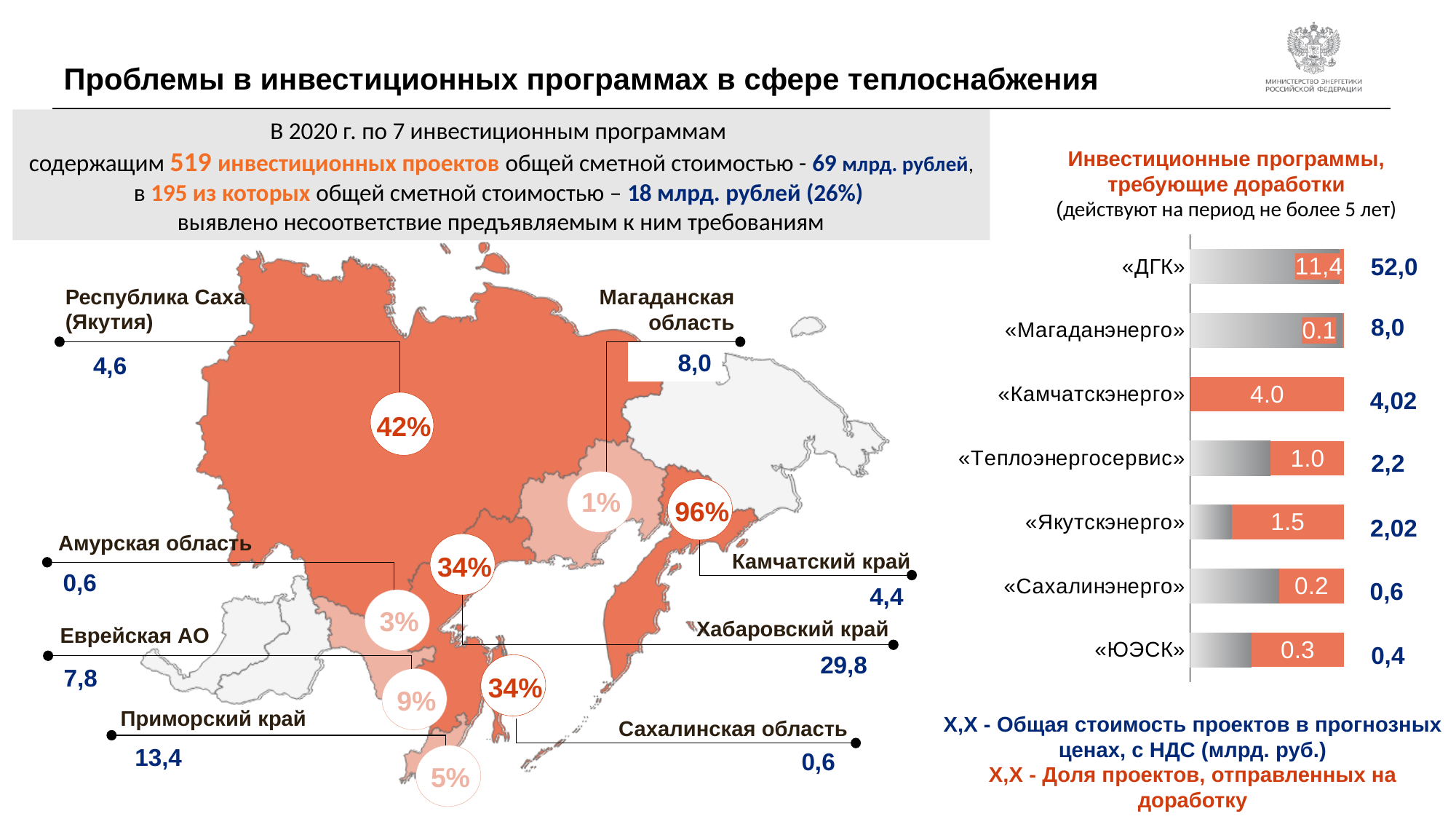
In the bar chart, which company has the highest total value shown to the right of the bars? «ДГК» In the bar chart, what total value is shown to the right of the bar for «ДГК»? 52,0 In the bar chart, what value is printed inside the bar for «ДГК»? 11,4 In the bar chart, which has the larger total value to the right of the bar: «Магаданэнерго» or «Сахалинэнерго»? «Магаданэнерго» How many companies are listed in the bar chart «Инвестиционные программы, требующие доработки»? 7 In the bar chart, what is the difference between the total values shown for «ДГК» (52,0) and «Магаданэнерго» (8,0)? 44,0 In the bar chart, which company has the lowest total value shown to the right of the bars? «ЮЭСК» What kind of chart is shown under the title «Инвестиционные программы, требующие доработки»? bar chart What is the title of the bar chart on the right side of the slide? Инвестиционные программы, требующие доработки In the bar chart, what value is printed inside the bar for «Камчатскэнерго»? 4.0 In the bar chart, what value is printed inside the bar for «Якутскэнерго»? 1.5 In the bar chart, what total value is shown to the right of the bar for «Теплоэнергосервис»? 2,2